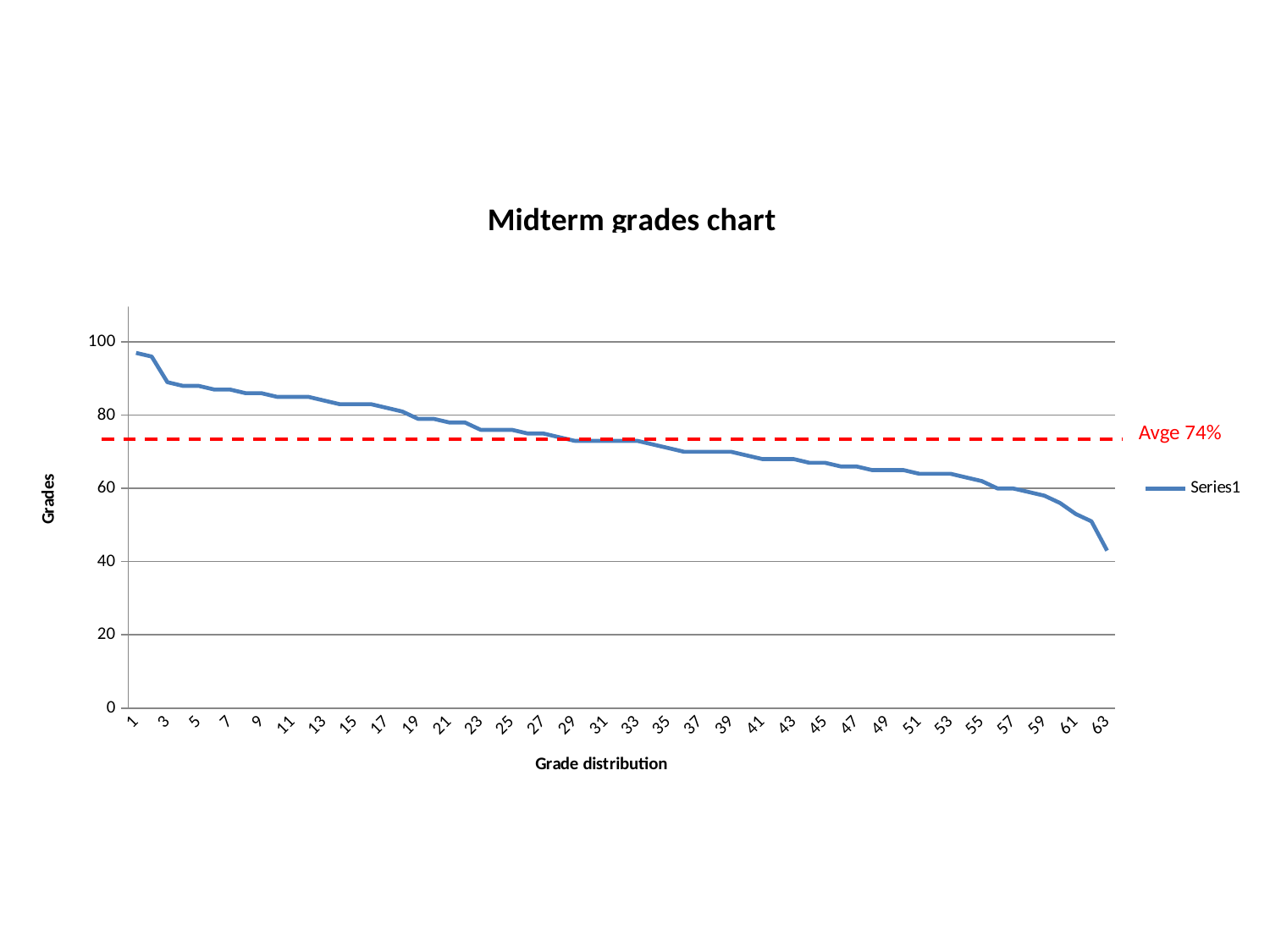
Which is larger, the value at x = 3 or the value at x = 59? x = 3 Is the value at x = 63 greater or less than 60? less Is the value at x = 21 greater or less than 60? greater Do the grade values rise or fall as you move along the x axis from 1 to 63? fall Which point on the x axis has the highest grade? 1 Is the value at x = 1 greater or less than 80? greater How many series does the legend list? 1 What average value is marked by the red dashed line? Avge 74% What type of chart is shown on the slide? line chart What is the title of the chart? Midterm grades chart Which point on the x axis has the lowest grade? 63